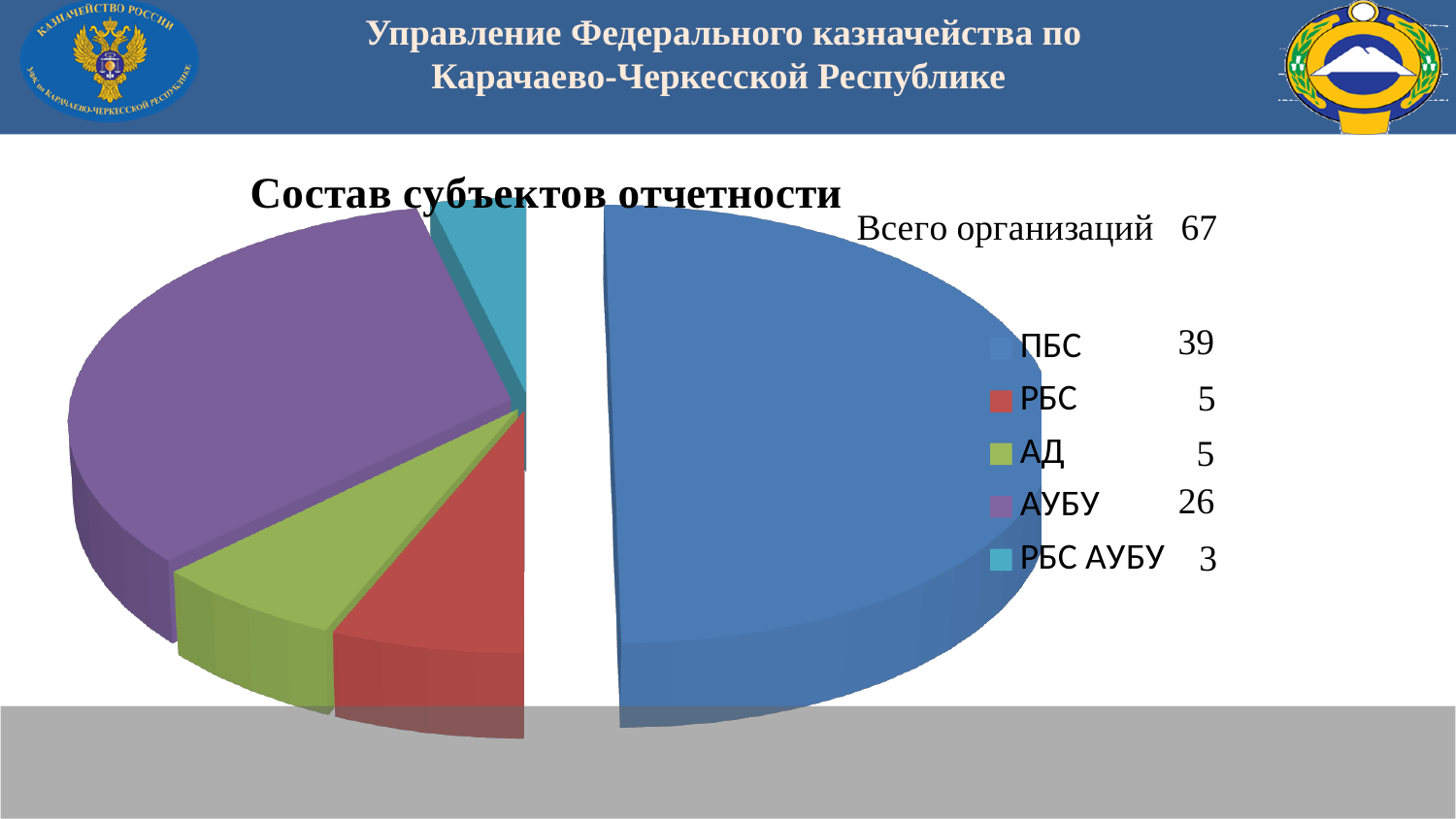
How many categories does the pie chart have? 5 What is the value for АД? 5 What is the value for РБС АУБУ? 3 What is the title of the chart? Состав субъектов отчетности What is the difference between the values for ПБС and АУБУ? 13 Which is larger, the value for АУБУ or the value for РБС? АУБУ What is the value for АУБУ? 26 What is the total number of organisations (Всего организаций) shown on the slide? 67 What is the value for ПБС? 39 What type of chart is shown on the slide? pie chart Which category has the largest value? ПБС Which category has the smallest value? РБС АУБУ